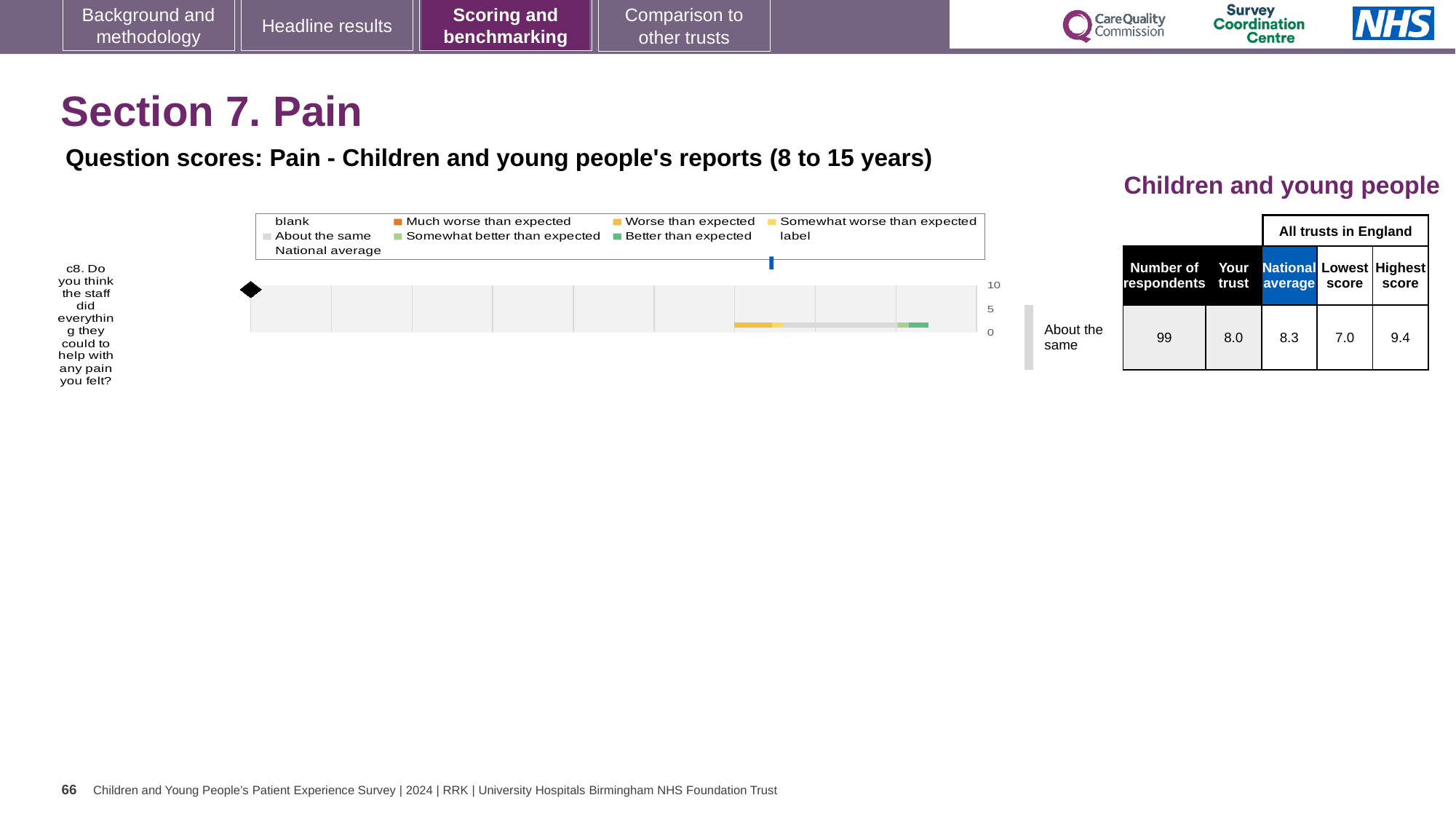
What is the lowest score among all trusts in England for question c8? 7.0 How many respondents answered question c8? 99 Which is larger for question c8, the 'Your trust' score or the national average? national average What is the maximum value shown on the chart's vertical axis? 10 How many survey questions are plotted on the chart? 1 What is the national average score for question c8? 8.3 What is the highest score among all trusts in England for question c8? 9.4 What is the 'Your trust' score for question c8? 8.0 What benchmark category is shown next to the chart for question c8? About the same Which survey question is plotted on the chart? c8. Do you think the staff did everything they could to help with any pain you felt? What is the difference between the highest and lowest scores for question c8? 2.4 What kind of chart is shown on the slide? bar chart